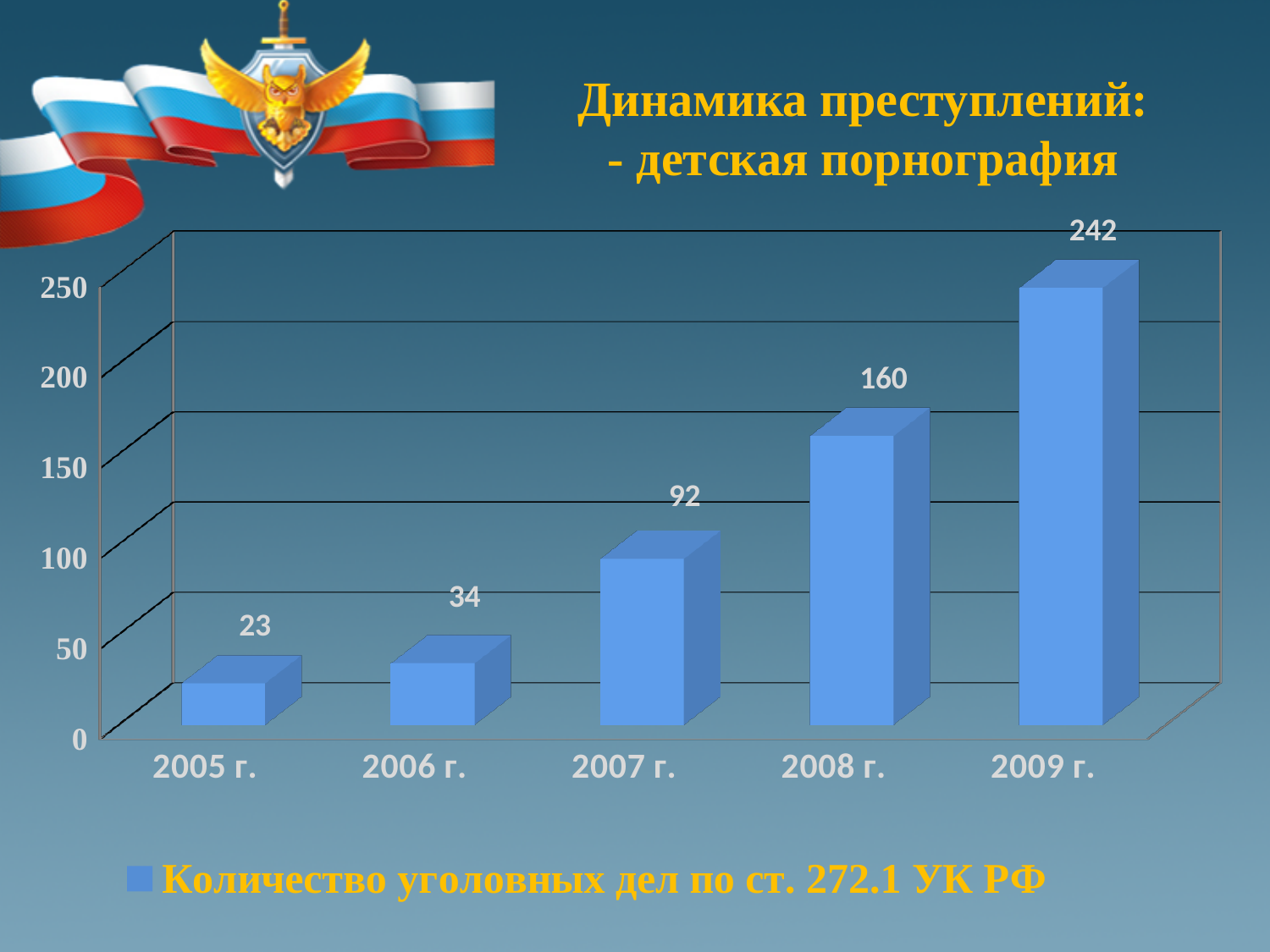
Which year has the lowest value? 2005 г. What is the value for 2007 г.? 92 Do the values rise or fall from 2005 г. to 2009 г.? rise How many years are shown on the x axis? 5 What is the value for 2009 г.? 242 Which year has the highest value? 2009 г. What kind of chart is shown on the slide? bar chart What is the difference between the values for 2009 г. and 2008 г.? 82 How many series does the legend list? 1 Which is larger, the value for 2007 г. or the value for 2008 г.? 2008 г. What is the difference between the values for 2006 г. and 2005 г.? 11 What is the value for 2005 г.? 23